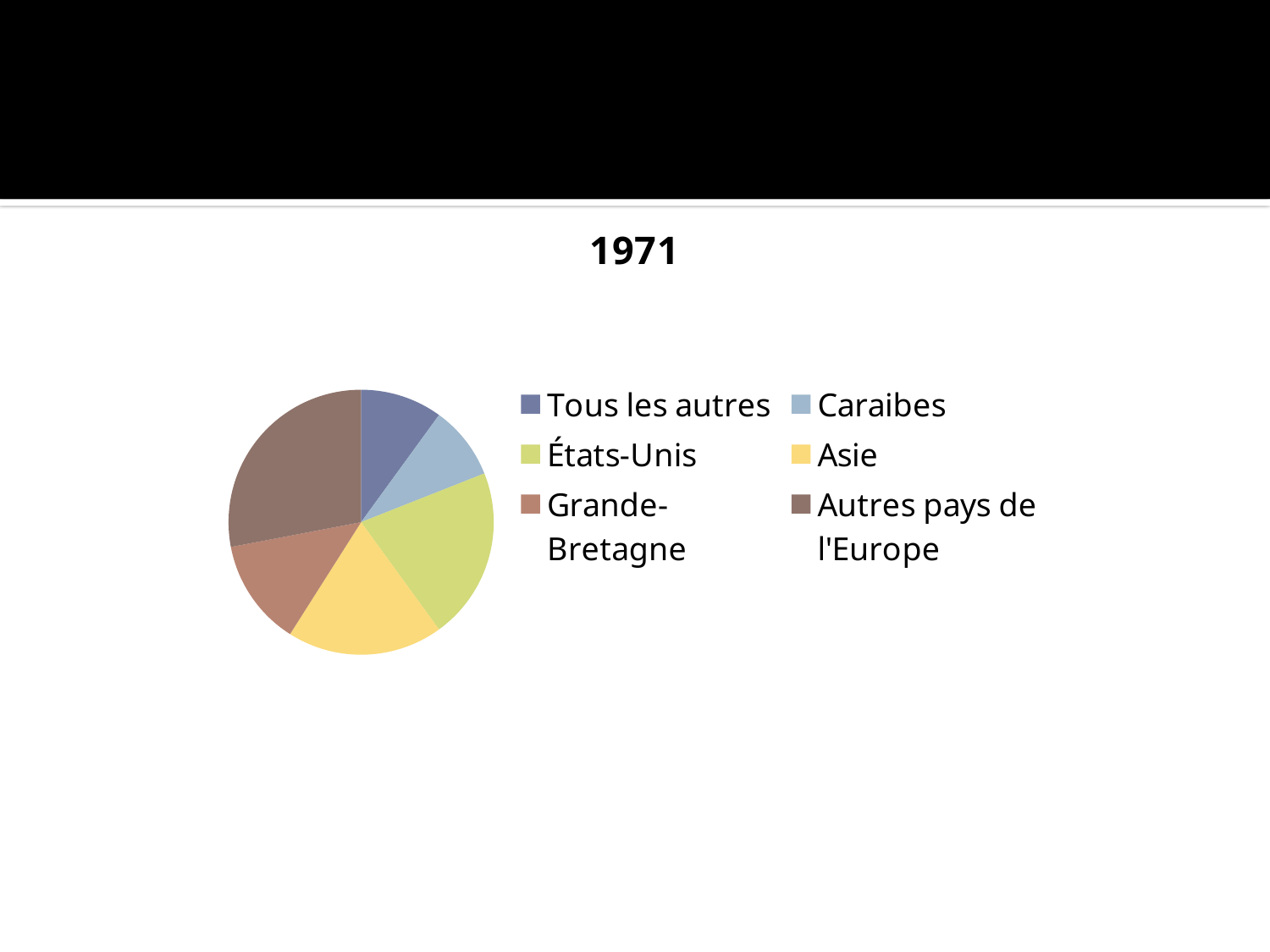
What is the title of the chart? 1971 What colour is the slice for Asie? yellow Which slice is larger, Autres pays de l'Europe or Grande-Bretagne? Autres pays de l'Europe Which slice is larger, Asie or Tous les autres? Asie How many entries does the legend list? 6 Which slice is larger, Autres pays de l'Europe or Asie? Autres pays de l'Europe What kind of chart is shown on the slide? pie chart Which category has the largest slice of the pie? Autres pays de l'Europe How many slices does the pie chart have? 6